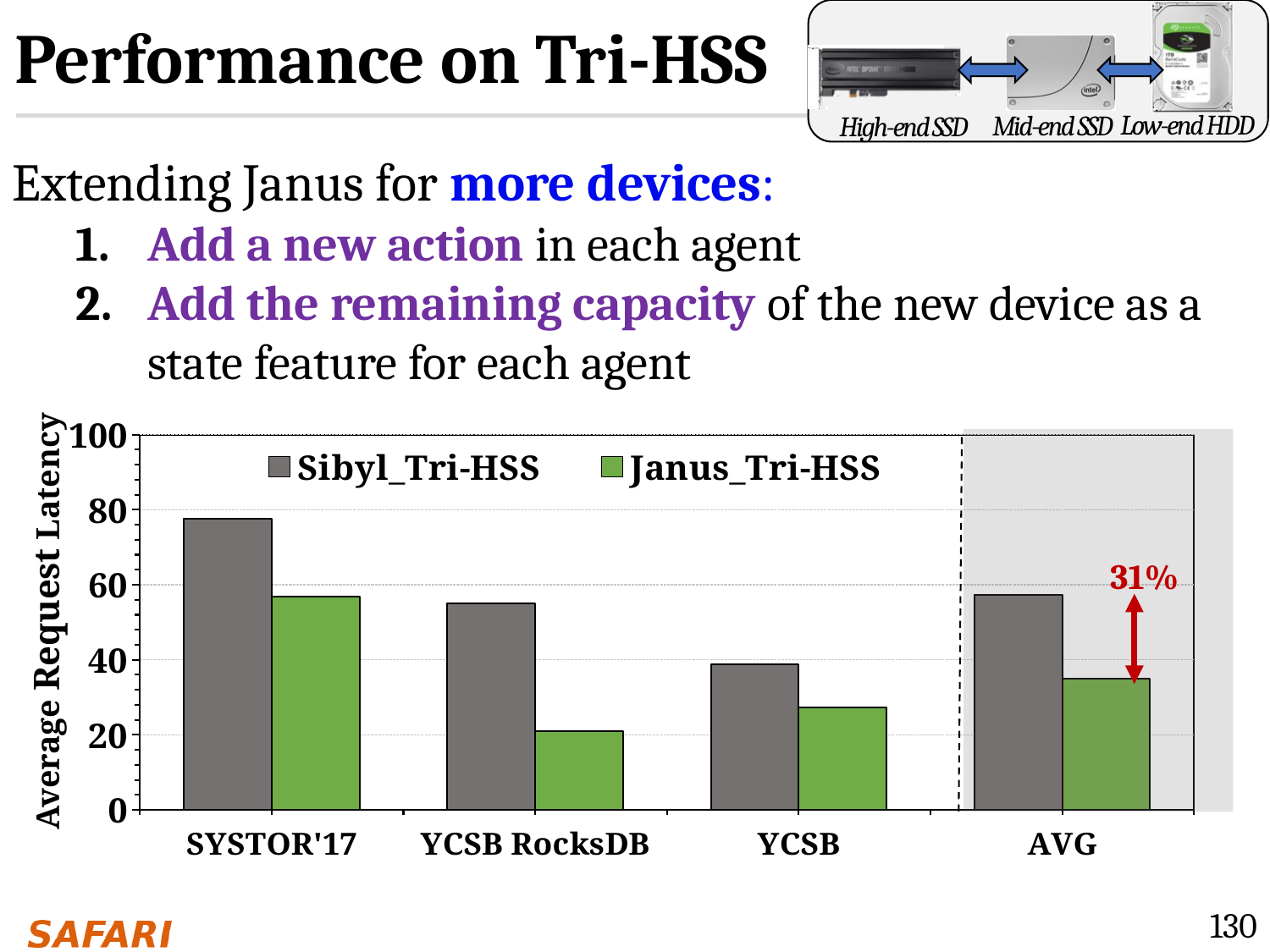
For SYSTOR'17, which series has the larger average request latency, Sibyl_Tri-HSS or Janus_Tri-HSS? Sibyl_Tri-HSS How many series does the chart legend list? 2 For which category is the Sibyl_Tri-HSS bar the highest? SYSTOR'17 For which category is the Sibyl_Tri-HSS bar the lowest? YCSB Is the Janus_Tri-HSS value for AVG greater or less than 40? less What kind of chart is shown on the slide? bar chart What is the label of the y axis of the chart? Average Request Latency Is the Sibyl_Tri-HSS value for SYSTOR'17 greater or less than 60? greater What percentage reduction is annotated on the AVG bars in the chart? 31% Is the Janus_Tri-HSS value for YCSB RocksDB greater or less than 40? less For which category is the Janus_Tri-HSS bar the lowest? YCSB RocksDB How many workload categories are shown on the x axis of the chart? 4